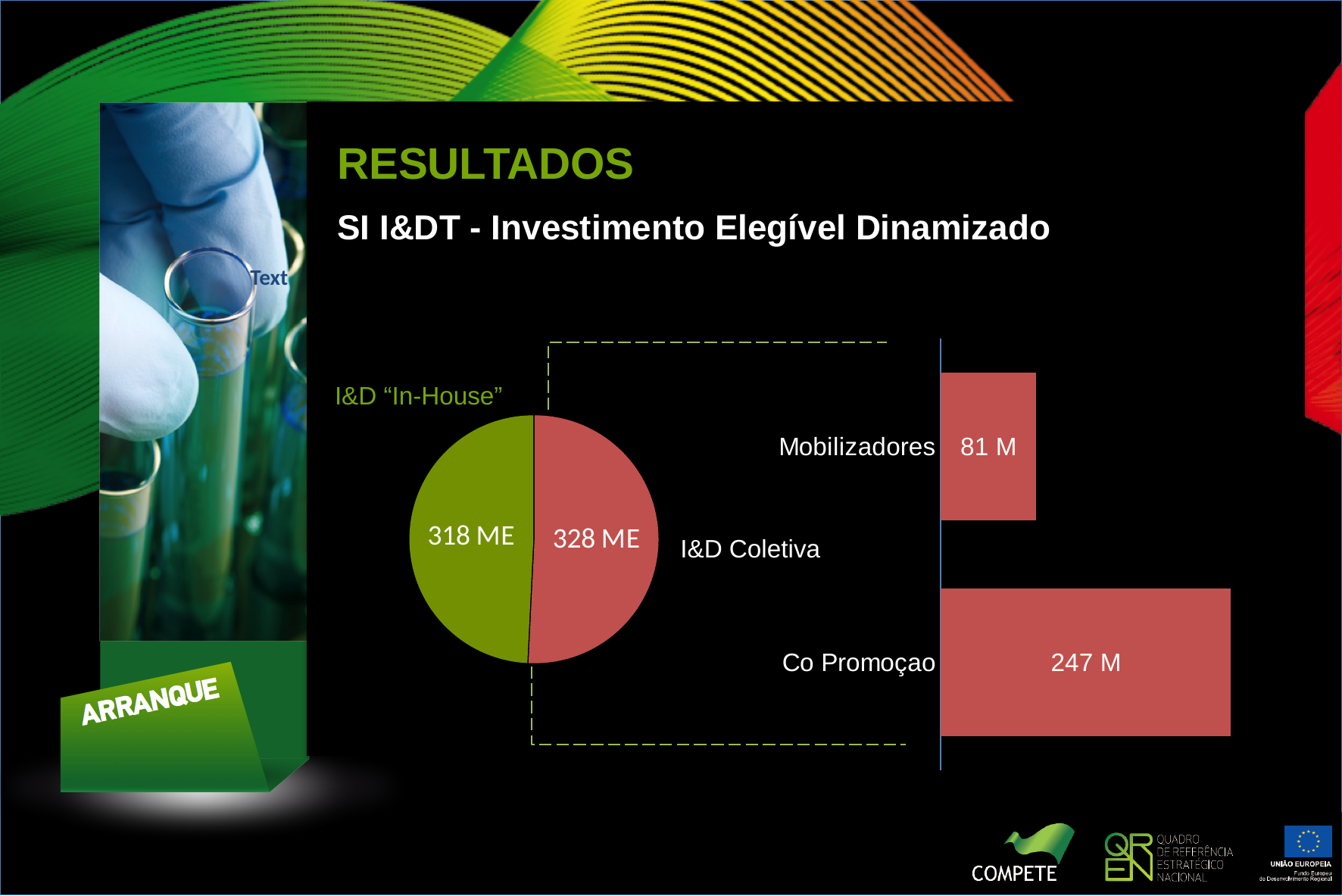
In the bar chart on the right, what is the difference between the Co Promoçao and Mobilizadores values? 166 M In the pie chart, what is the value for I&D "In-House"? 318 ME How many slices does the pie chart have? 2 In the bar chart on the right, what is the value for Co Promoçao? 247 M In the pie chart, which slice is larger, I&D "In-House" or I&D Coletiva? I&D Coletiva What kind of chart is the chart on the left of the slide? pie chart In the pie chart, what is the difference between the I&D Coletiva and I&D "In-House" values? 10 ME What kind of chart is the chart on the right of the slide? bar chart In the bar chart on the right, which category has the lowest value? Mobilizadores In the bar chart on the right, what is the value for Mobilizadores? 81 M In the pie chart, what is the value for I&D Coletiva? 328 ME In the bar chart on the right, which category has the highest value? Co Promoçao